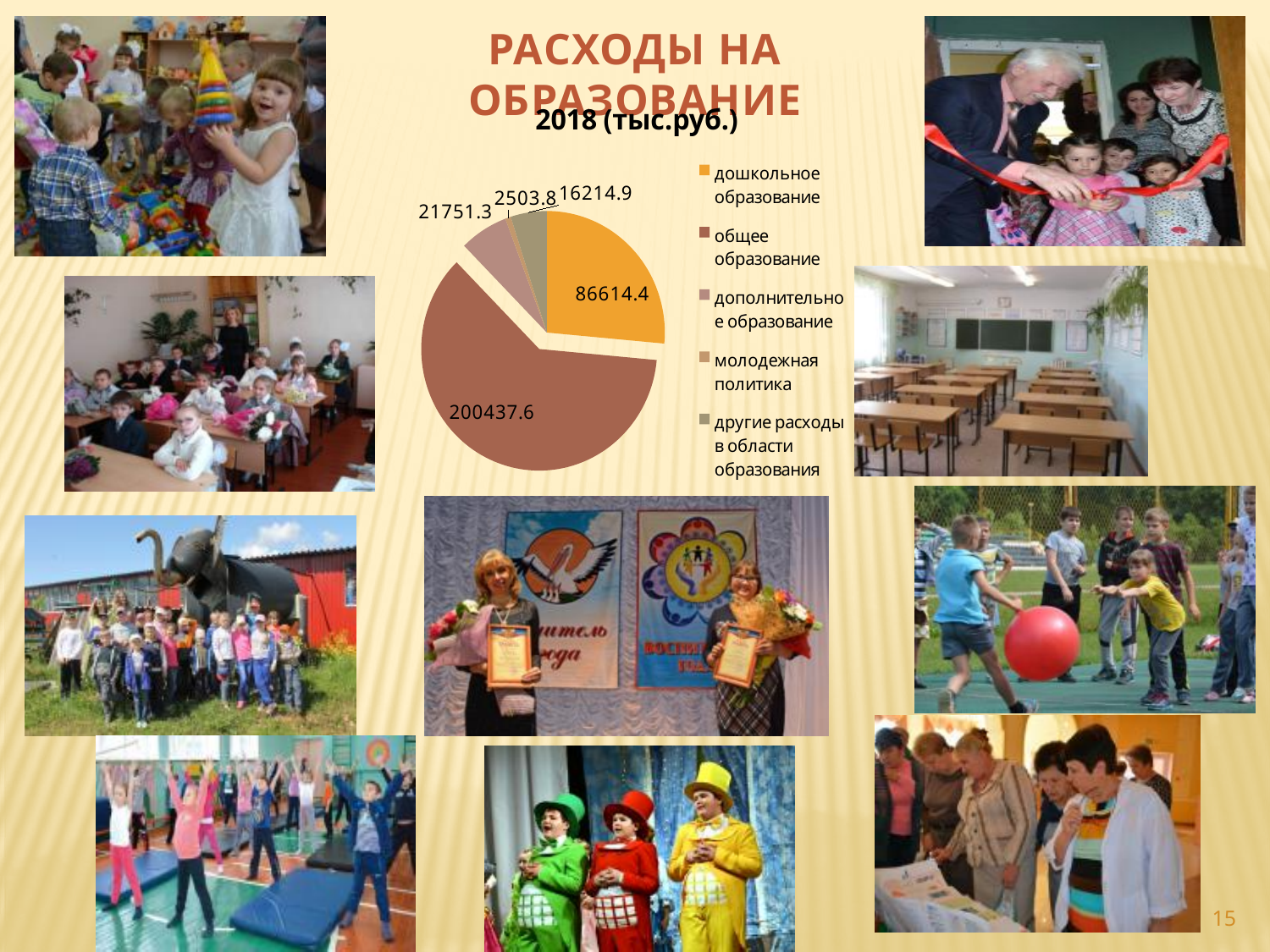
Which is larger: дополнительное образование or другие расходы в области образования? дополнительное образование What is the value for молодежная политика? 2503.8 Which category has the smallest slice of the pie? молодежная политика Which category has the largest slice of the pie? общее образование What kind of chart is shown on the slide? pie chart What is the value for дополнительное образование? 21751.3 What is the value for общее образование? 200437.6 What is the value for другие расходы в области образования? 16214.9 What is the value for дошкольное образование? 86614.4 What is the difference between the values for общее образование and дошкольное образование? 113823.2 What is the title of the chart? 2018 (тыс.руб.) How many categories does the legend of the pie chart list? 5